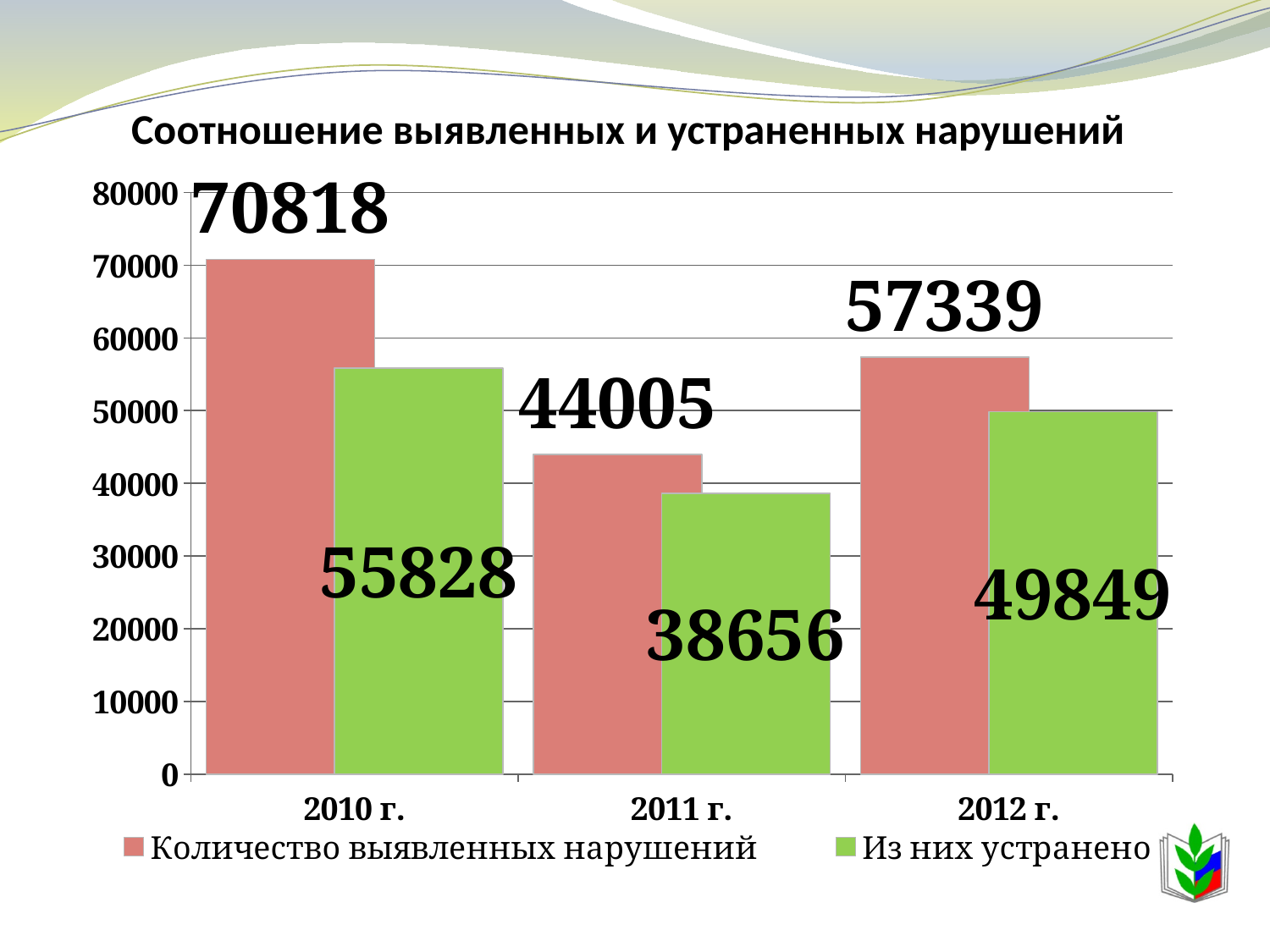
How many series does the legend list? 2 Which is larger: "Из них устранено" in 2010 г. or "Количество выявленных нарушений" in 2011 г.? Из них устранено in 2010 г. What is the difference between "Количество выявленных нарушений" in 2010 г. and in 2011 г.? 26813 What is the value of "Из них устранено" for 2012 г.? 49849 Is the value of "Из них устранено" for 2012 г. greater or less than 50000? less Which year has the lowest value for "Из них устранено"? 2011 г. What is the difference between "Количество выявленных нарушений" and "Из них устранено" in 2012 г.? 7490 What is the value of "Из них устранено" for 2011 г.? 38656 What type of chart is shown on the slide? bar chart What is the value of "Количество выявленных нарушений" for 2010 г.? 70818 How many years are shown on the x axis? 3 Which year has the highest value for "Количество выявленных нарушений"? 2010 г.